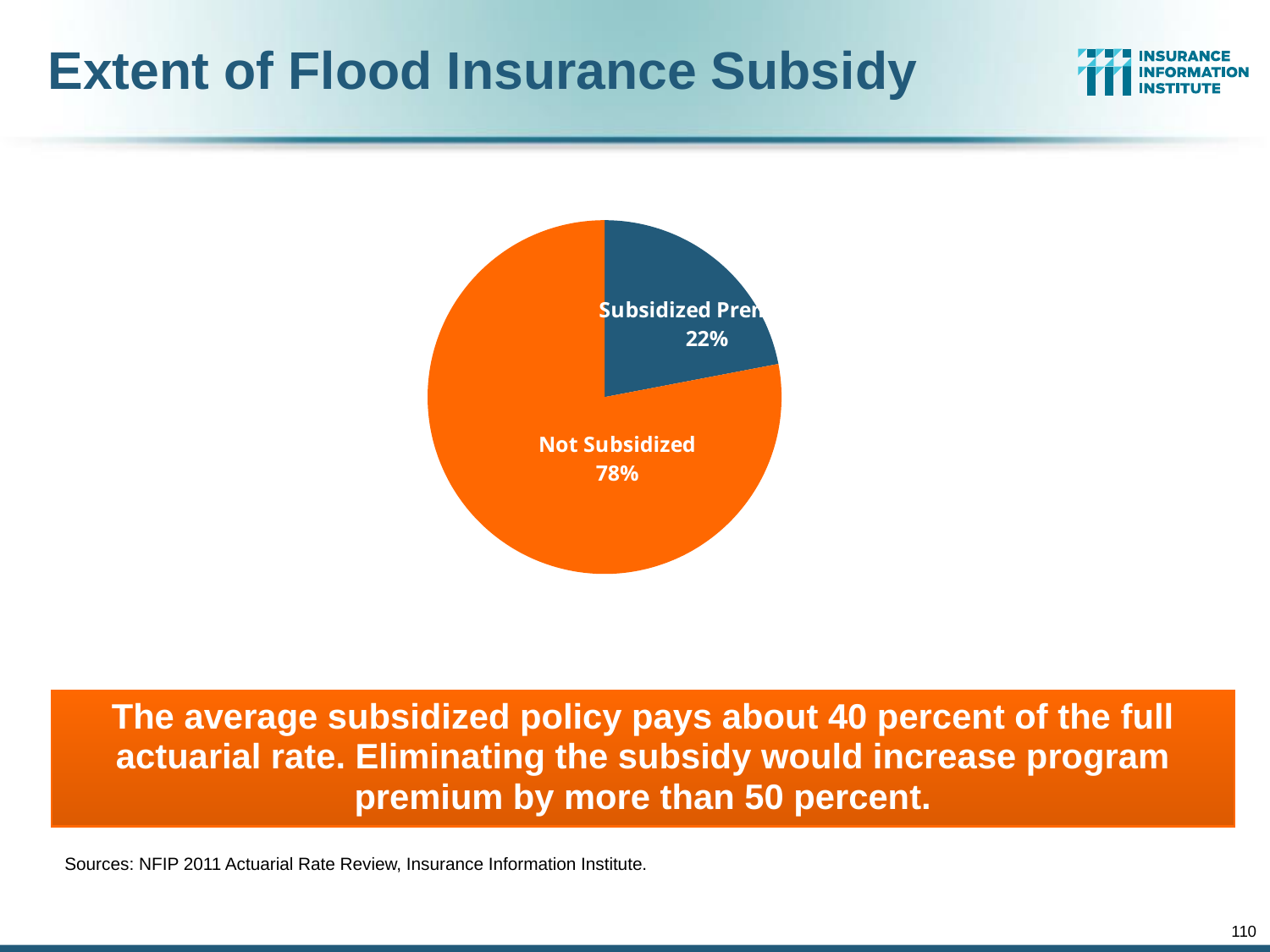
What colour is the Not Subsidized slice of the pie? Orange What is the difference in percentage points between the Not Subsidized slice and the Subsidized slice? 56 Which slice of the pie is the largest? Not Subsidized What share of the pie is labelled Not Subsidized? 78% How many slices does the pie chart have? 2 Which slice of the pie is the smallest? Subsidized What share of the pie is the Subsidized slice? 22% Which is larger, the Not Subsidized slice or the Subsidized slice? Not Subsidized Is the Not Subsidized share greater or less than 50%? greater What kind of chart is shown on the slide? Pie chart What is the title of the slide containing the pie chart? Extent of Flood Insurance Subsidy What do the two slices of the pie add up to? 100%